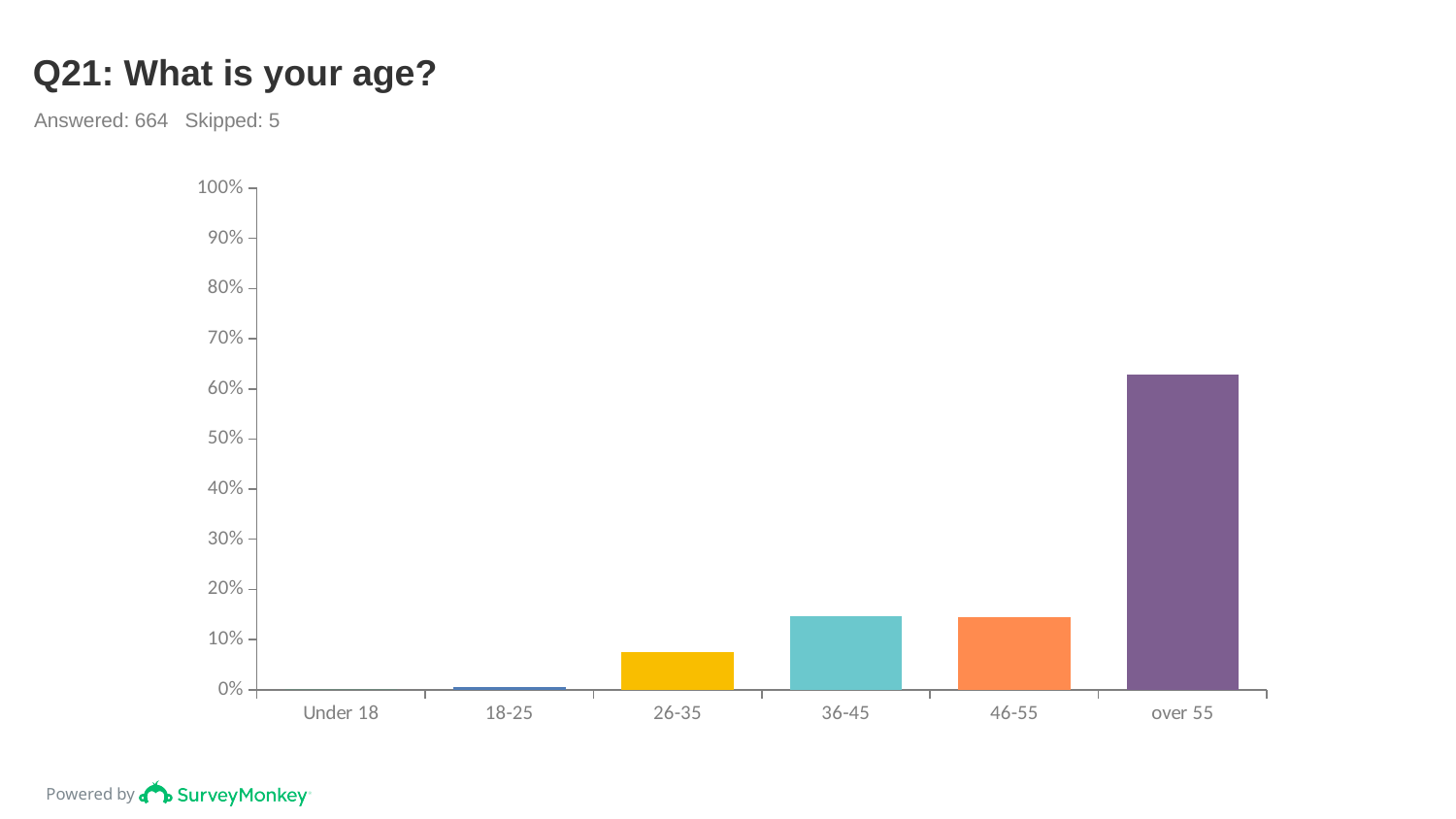
How many age categories are shown on the x axis? 6 Which age category has the highest value? over 55 Is the value for over 55 greater or less than 60%? greater Which is larger, the value for over 55 or the value for 26-35? over 55 What kind of chart is shown on the slide? bar chart Is the value for 26-35 greater or less than 10%? less How many respondents answered the question according to the slide? 664 Is the value for 46-55 greater or less than 20%? less What is the title of the chart? Q21: What is your age? Which is larger, the value for 36-45 or the value for 18-25? 36-45